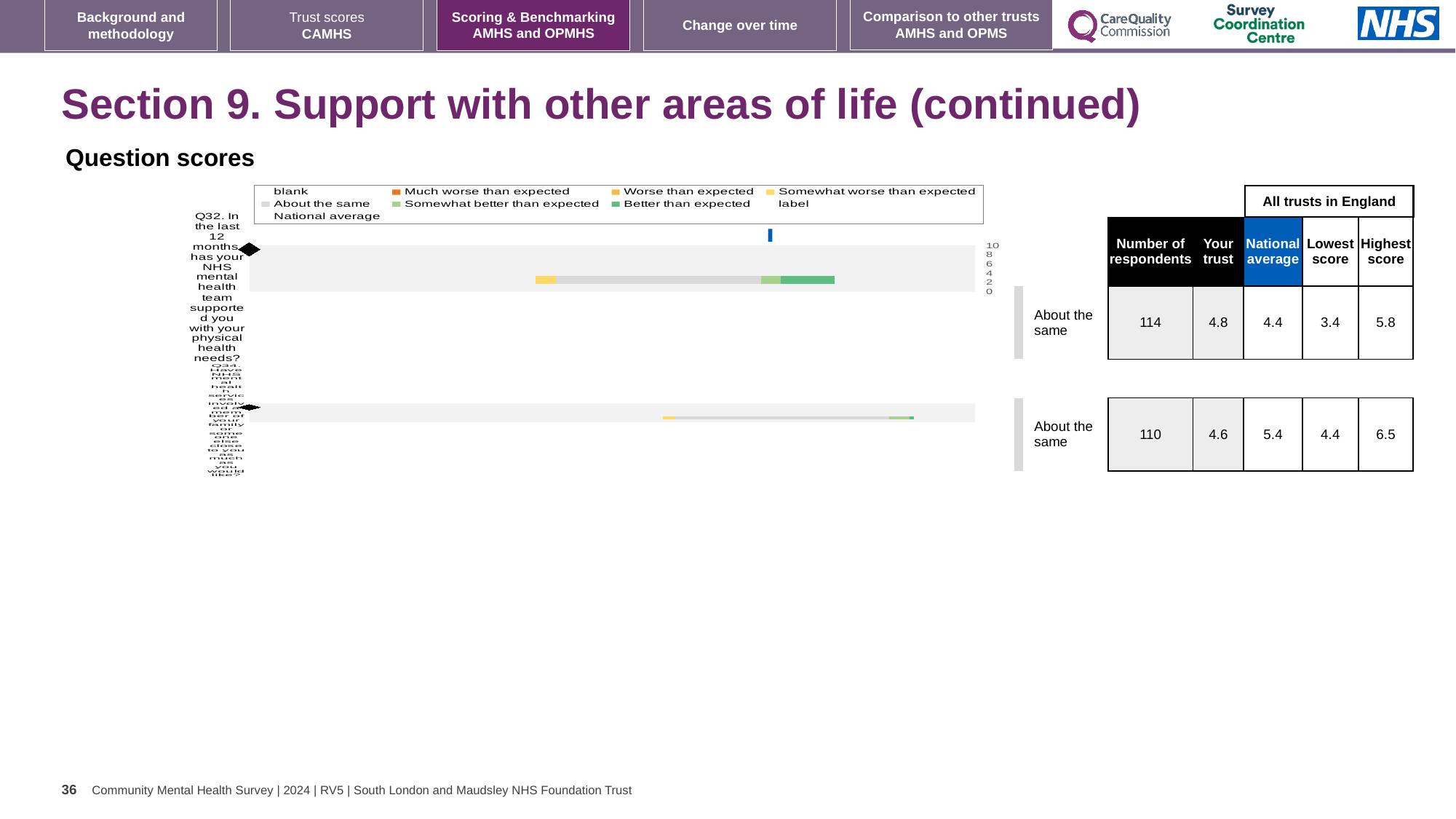
Which question is plotted in the top row of the question scores chart? Q32. In the last 12 months has your NHS mental health team supported you with your physical health needs? What is the lowest score across all trusts in England for Q34 in the table next to the chart? 4.4 How many respondents are listed for Q32 in the table next to the chart? 114 In the legend of the question scores chart, which entry is shown in dark green? Better than expected What kind of chart is shown under "Question scores"? bar chart What is the national average for Q32 in the table next to the chart? 4.4 How many questions (categories) are plotted in the question scores chart? 2 For Q34, which is larger: the "Your trust" score or the national average? National average For Q32, which is larger: the "Your trust" score or the national average? Your trust What is the difference between the highest score and the lowest score for Q32 in the table next to the chart? 2.4 What is the "Your trust" score for Q32 in the table next to the chart? 4.8 What is the highest score across all trusts in England for Q34 in the table next to the chart? 6.5